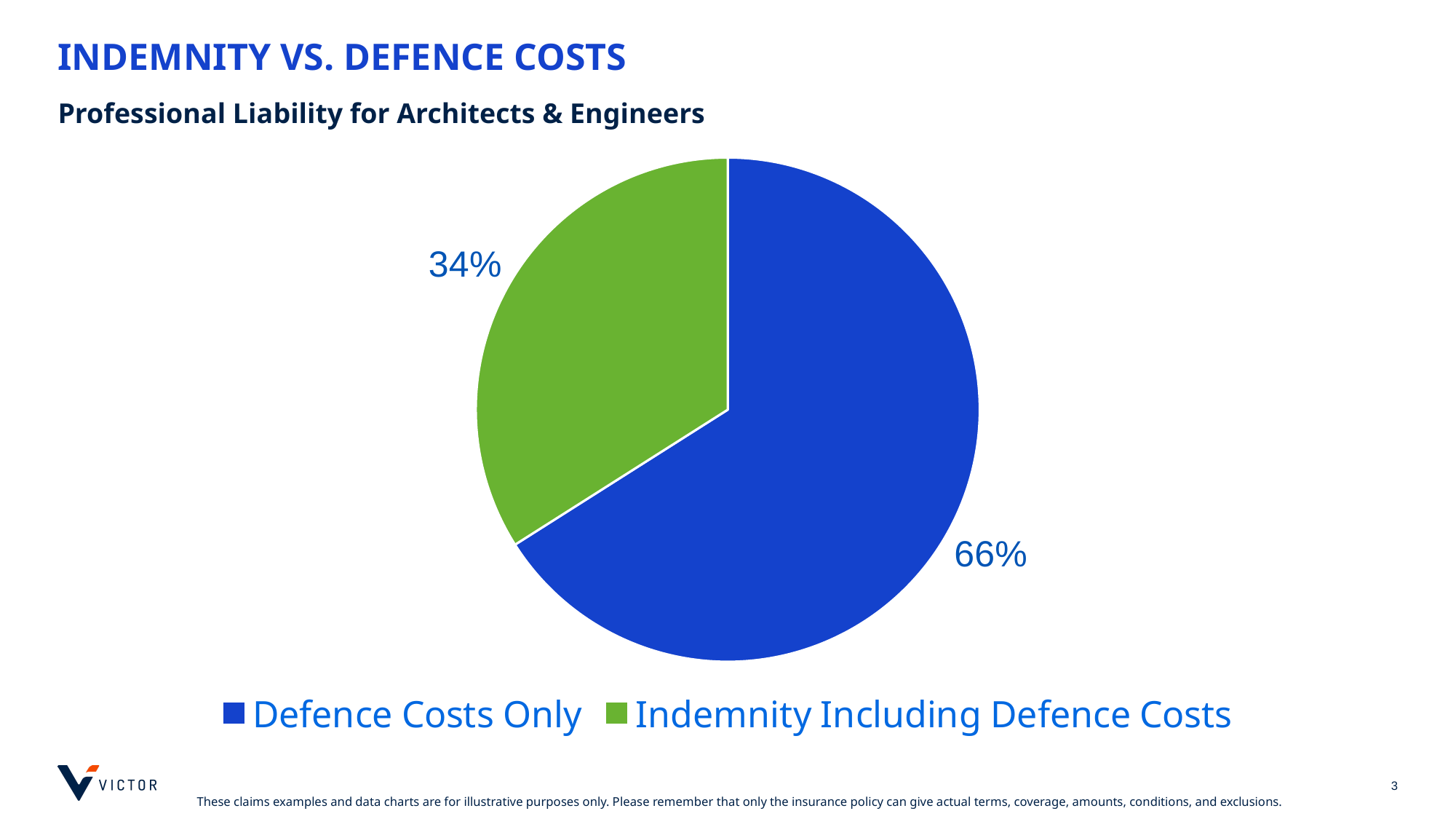
Which slice of the pie is the smallest? Indemnity Including Defence Costs Which is larger: the Defence Costs Only slice or the Indemnity Including Defence Costs slice? Defence Costs Only How many entries does the legend list? 2 What is the difference in percentage points between the Defence Costs Only slice and the Indemnity Including Defence Costs slice? 32 What is the title of the slide containing the pie chart? INDEMNITY VS. DEFENCE COSTS What share of the pie is labelled Defence Costs Only? 66% Which slice of the pie is the largest? Defence Costs Only How many slices does the pie chart have? 2 What kind of chart is shown on the slide? pie chart What share of the pie is labelled Indemnity Including Defence Costs? 34% What colour is the Indemnity Including Defence Costs slice? green